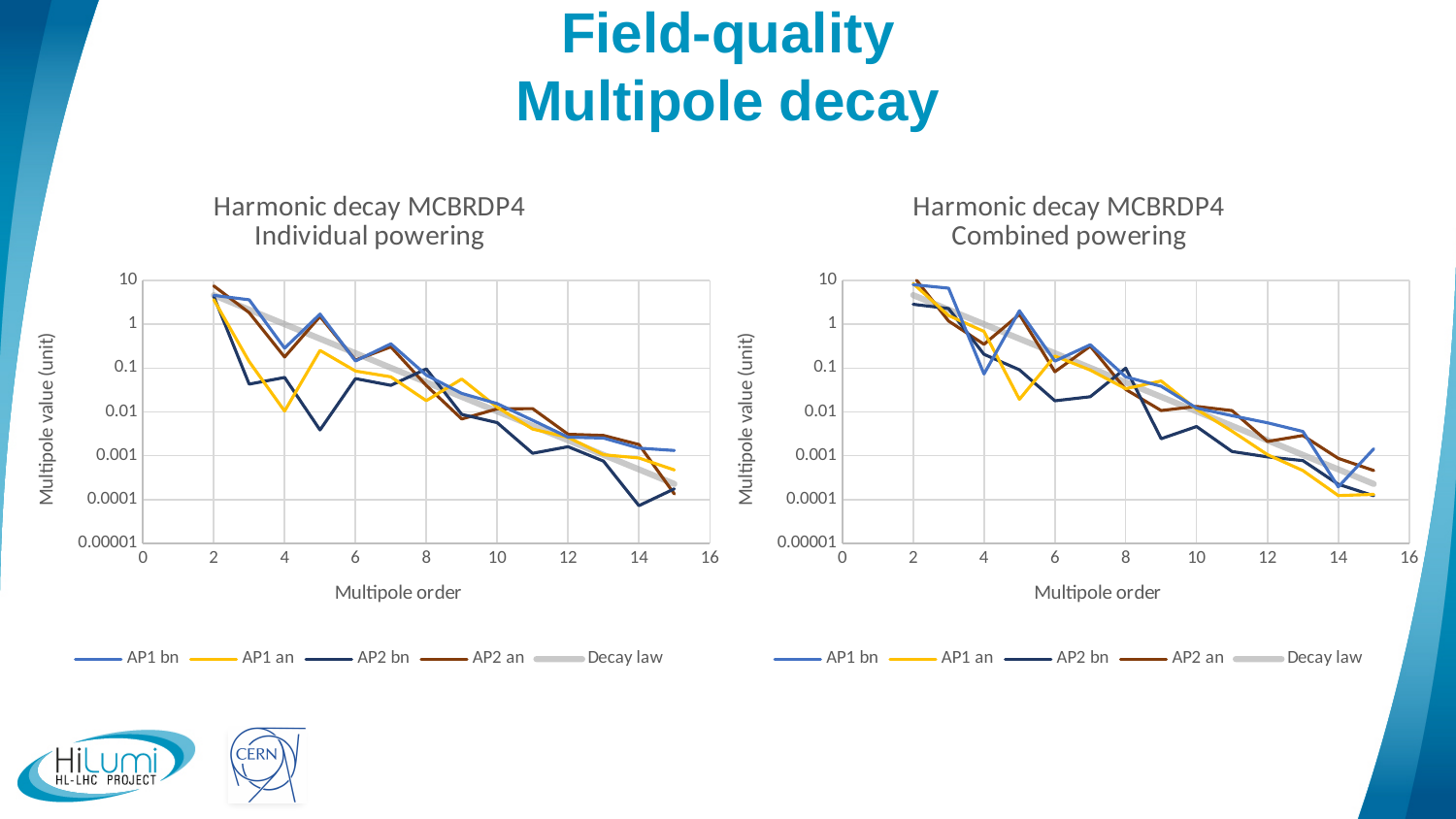
In the 'Harmonic decay MCBRDP4 Combined powering' chart, does the Decay law line rise or fall along the x axis? fall In the 'Harmonic decay MCBRDP4 Individual powering' chart, do the multipole values generally rise or fall as the multipole order increases? fall How many series does the legend of the 'Harmonic decay MCBRDP4 Combined powering' chart list? 5 What kind of chart is the 'Harmonic decay MCBRDP4 Individual powering' chart? line chart In the 'Harmonic decay MCBRDP4 Individual powering' chart, is the value of AP1 bn at multipole order 3 greater or less than 1? greater What is the y-axis label of the 'Harmonic decay MCBRDP4 Combined powering' chart? Multipole value (unit) In the 'Harmonic decay MCBRDP4 Individual powering' chart, is the value of AP2 bn at multipole order 14 greater or less than 0.0001? less In the 'Harmonic decay MCBRDP4 Combined powering' chart, is the value of AP1 an at multipole order 14 greater or less than 0.001? less What is the x-axis label of the 'Harmonic decay MCBRDP4 Individual powering' chart? Multipole order